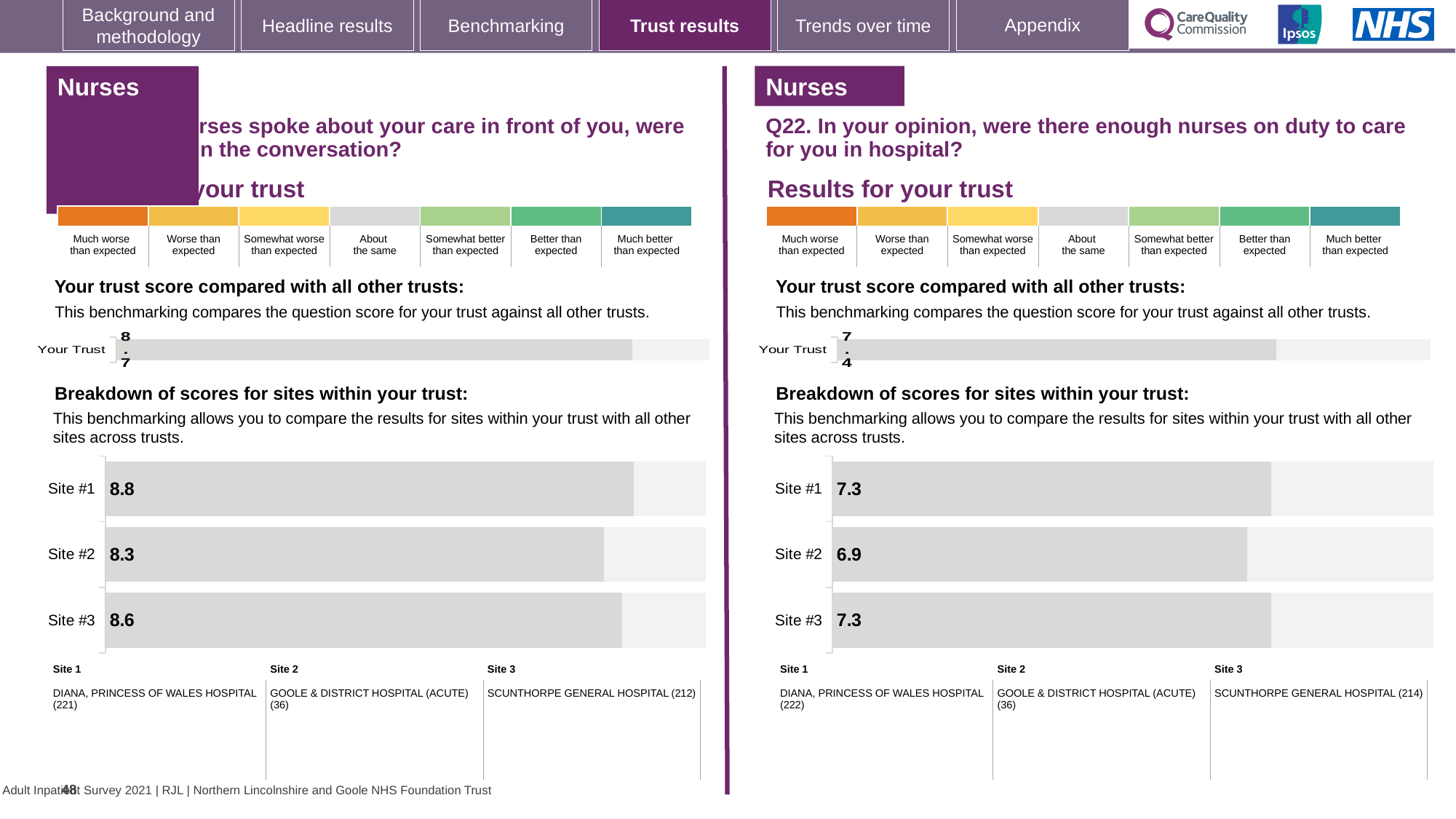
On the Q22 'Your trust score compared with all other trusts' chart, what is the score for Your Trust? 7.4 On the left-hand site breakdown chart, what is the score for Site #1? 8.8 How many sites are shown on the Q22 site breakdown chart? 3 On the Q22 site breakdown chart, what is the score for Site #2? 6.9 On the left-hand site breakdown chart, what is the difference between the scores for Site #1 and Site #2? 0.5 On the left-hand 'Your trust score compared with all other trusts' chart, what is the score for Your Trust? 8.7 On the Q22 site breakdown chart, which site has the lowest score? Site #2 On the Q22 site breakdown chart, what is the difference between the scores for Site #1 and Site #2? 0.4 On the left-hand site breakdown chart, which site has the lowest score? Site #2 On the left-hand site breakdown chart, what is the score for Site #2? 8.3 On the Q22 site breakdown chart, what is the score for Site #3? 7.3 What kind of chart is the Q22 site breakdown chart? Bar chart